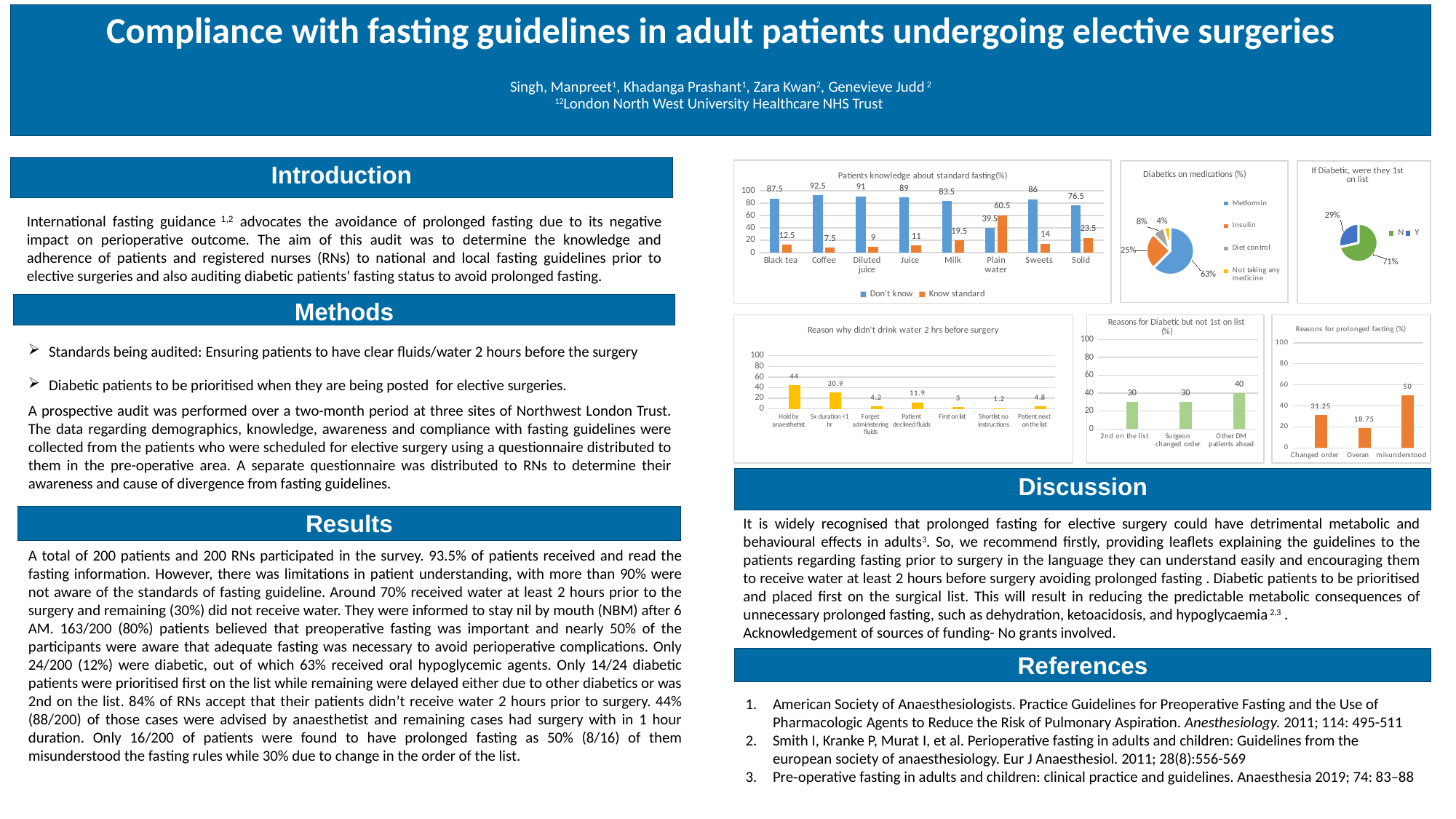
In the chart titled 'Patients knowledge about standard fasting(%)', what is the 'Know standard' value for Plain water? 60.5 In the chart titled 'Reasons for Diabetic but not 1st on list (%)', which category has the highest value? Other DM patients ahead In the chart titled 'Patients knowledge about standard fasting(%)', which category has the lowest 'Don't know' value? Plain water In the pie chart titled 'Diabetics on medications (%)', which category has the smallest slice? Not taking any medicine In the pie chart titled 'Diabetics on medications (%)', what share is Metformin? 63% In the chart titled 'Patients knowledge about standard fasting(%)', how many series does the legend list? 2 In the pie chart titled 'If Diabetic, were they 1st on list', what share is Y? 29% How many categories are shown in the chart titled 'Reason why didn't drink water 2 hrs before surgery'? 7 In the chart titled 'Patients knowledge about standard fasting(%)', what is the 'Don't know' value for Coffee? 92.5 In the chart titled 'Reason why didn't drink water 2 hrs before surgery', what is the value for 'Hold by anaesthetist'? 44 In the chart titled 'Reasons for prolonged fasting (%)', what is the difference between 'misunderstood' and 'Overan'? 31.25 In the chart titled 'Patients knowledge about standard fasting(%)', what is the difference between the 'Don't know' values for Coffee and Solid? 16